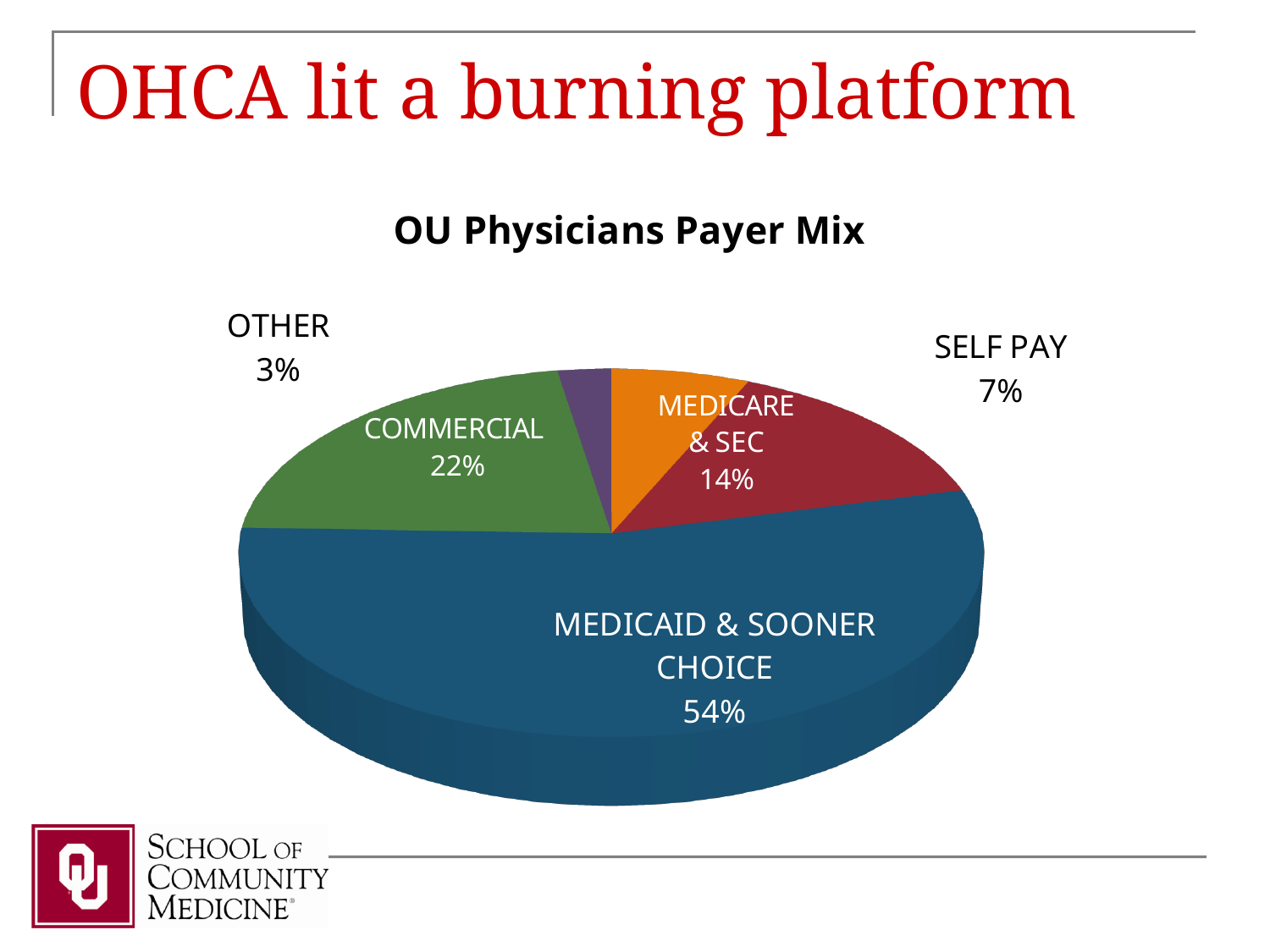
Which has a larger share of the payer mix, Medicare & Sec or Self Pay? Medicare & Sec What share of the OU Physicians Payer Mix is Medicaid & Sooner Choice? 54% Which payer category has the largest share of the OU Physicians Payer Mix? Medicaid & Sooner Choice Which payer category has the smallest share of the OU Physicians Payer Mix? Other What kind of chart is used to show the OU Physicians Payer Mix? Pie chart What share of the OU Physicians Payer Mix is Medicare & Sec? 14% What share of the OU Physicians Payer Mix is Other? 3% What share of the OU Physicians Payer Mix is Self Pay? 7% How many payer categories are shown in the OU Physicians Payer Mix pie chart? 5 What is the title of the chart on the slide? OU Physicians Payer Mix What share of the OU Physicians Payer Mix is Commercial? 22% How many percentage points larger is the Medicaid & Sooner Choice share than the Commercial share? 32